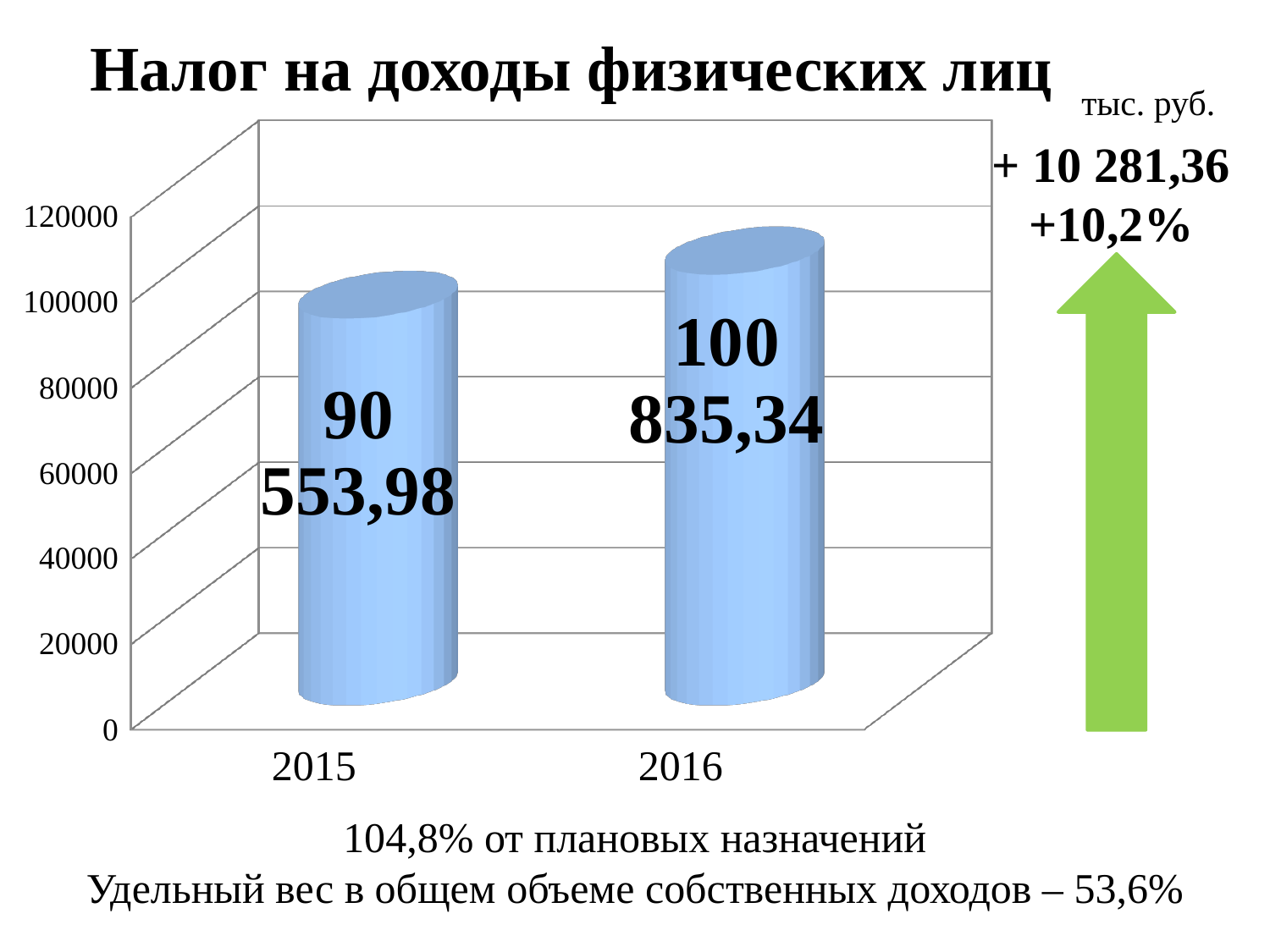
Do the values rise or fall from 2015 to 2016? rise What kind of chart is shown on the slide? bar chart Is the value for 2015 greater or less than 80000? greater What is the difference between the 2016 and 2015 values? 10 281,36 Is the value for 2016 greater or less than 120000? less Is the value for 2016 larger or smaller than the value for 2015? larger Which year has the higher value on the chart? 2016 What is the title of the chart? Налог на доходы физических лиц What is the value for 2015 on the chart? 90 553,98 Which year has the lower value on the chart? 2015 What is the value for 2016 on the chart? 100 835,34 How many categories (years) are shown on the chart? 2